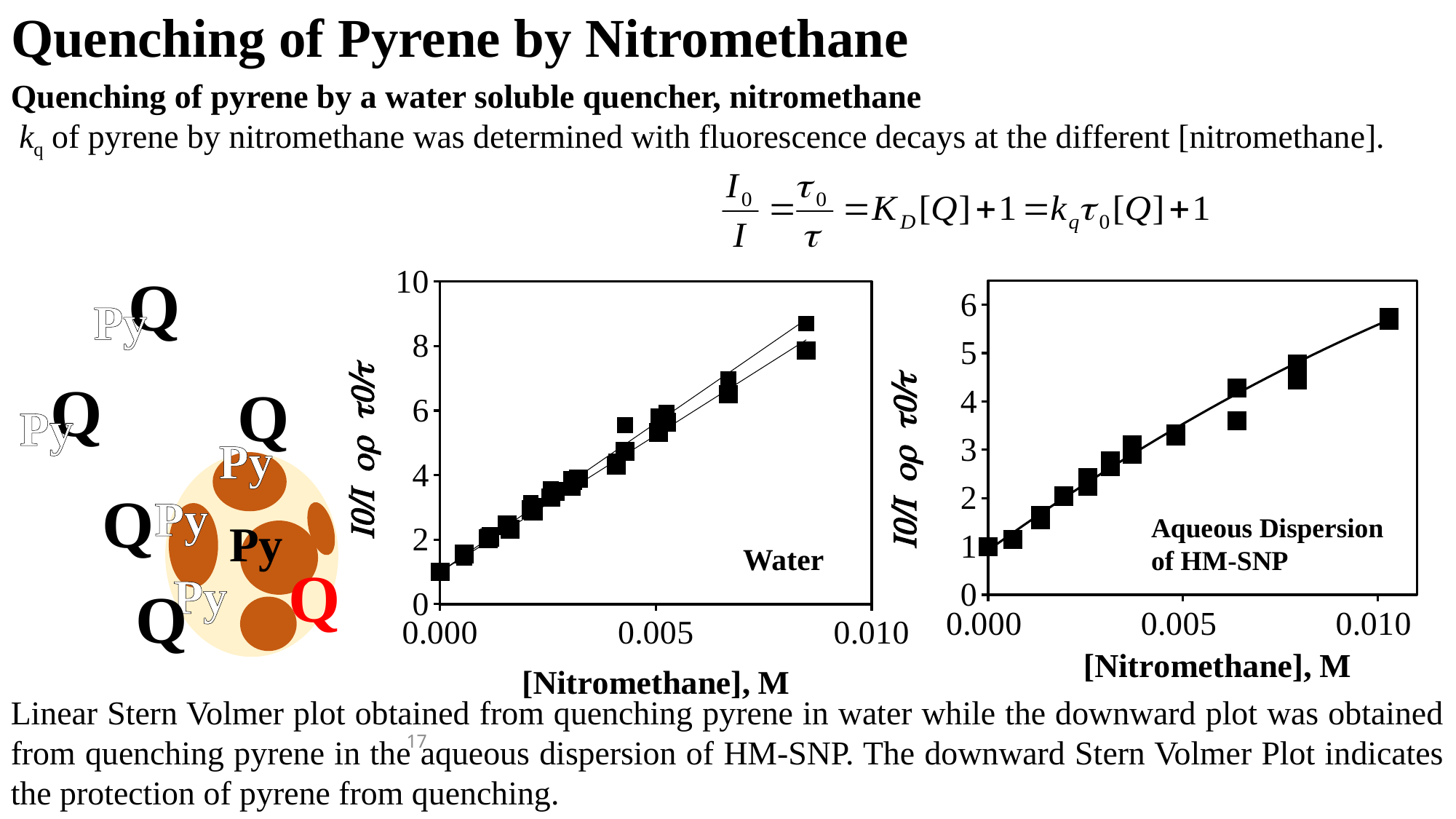
In the "Water" chart, is the value at 0.000 M nitromethane greater or less than 2? less Which chart reaches a higher maximum y-axis tick value, the "Water" chart or the "Aqueous Dispersion of HM-SNP" chart? Water What kind of chart is the left chart labelled "Water"? Scatter plot with fitted lines In the "Water" chart, do the I0/I values rise or fall as [Nitromethane] increases? Rise In the "Water" chart, is the value at the highest nitromethane concentration greater or less than 6? greater What is the highest tick value on the y axis of the "Aqueous Dispersion of HM-SNP" chart? 6 In the "Aqueous Dispersion of HM-SNP" chart, is the value at about 0.005 M nitromethane greater or less than 4? less What is the x-axis label of the "Water" chart? [Nitromethane], M In the "Aqueous Dispersion of HM-SNP" chart, do the values rise or fall along the x axis? Rise